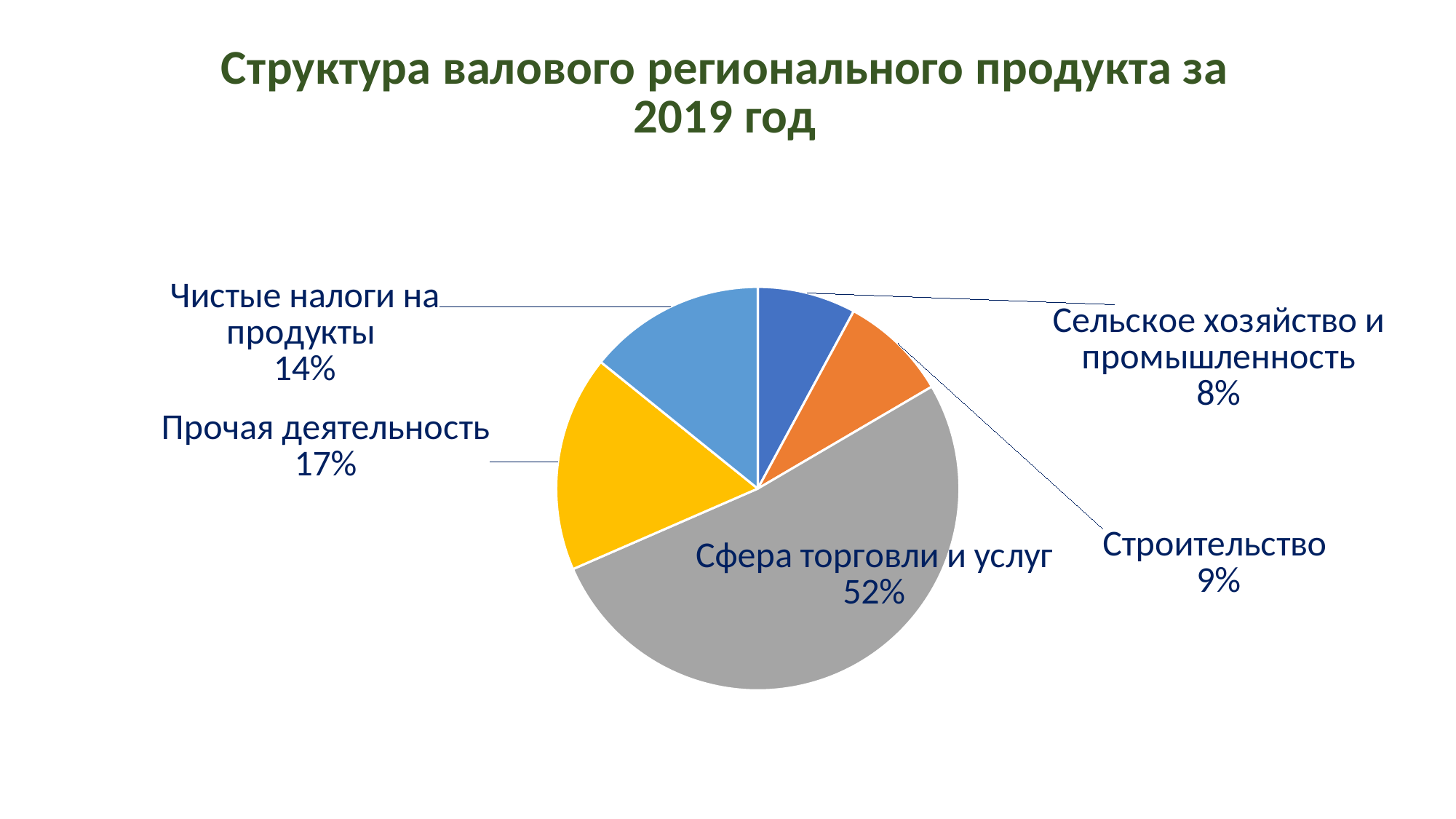
Which category has the largest share of the pie? Сфера торговли и услуг What is the value for Сельское хозяйство и промышленность? 8% What is the difference between the shares of Сфера торговли и услуг and Прочая деятельность? 35% What type of chart is shown on the slide? pie chart Which is larger, the share for Чистые налоги на продукты or the share for Строительство? Чистые налоги на продукты What is the value for Прочая деятельность? 17% How many slices does the pie chart have? 5 What is the title of the chart? Структура валового регионального продукта за 2019 год What is the value for Чистые налоги на продукты? 14% What is the value for Строительство? 9% What share of the pie does Сфера торговли и услуг have? 52% Which category has the smallest share of the pie? Сельское хозяйство и промышленность